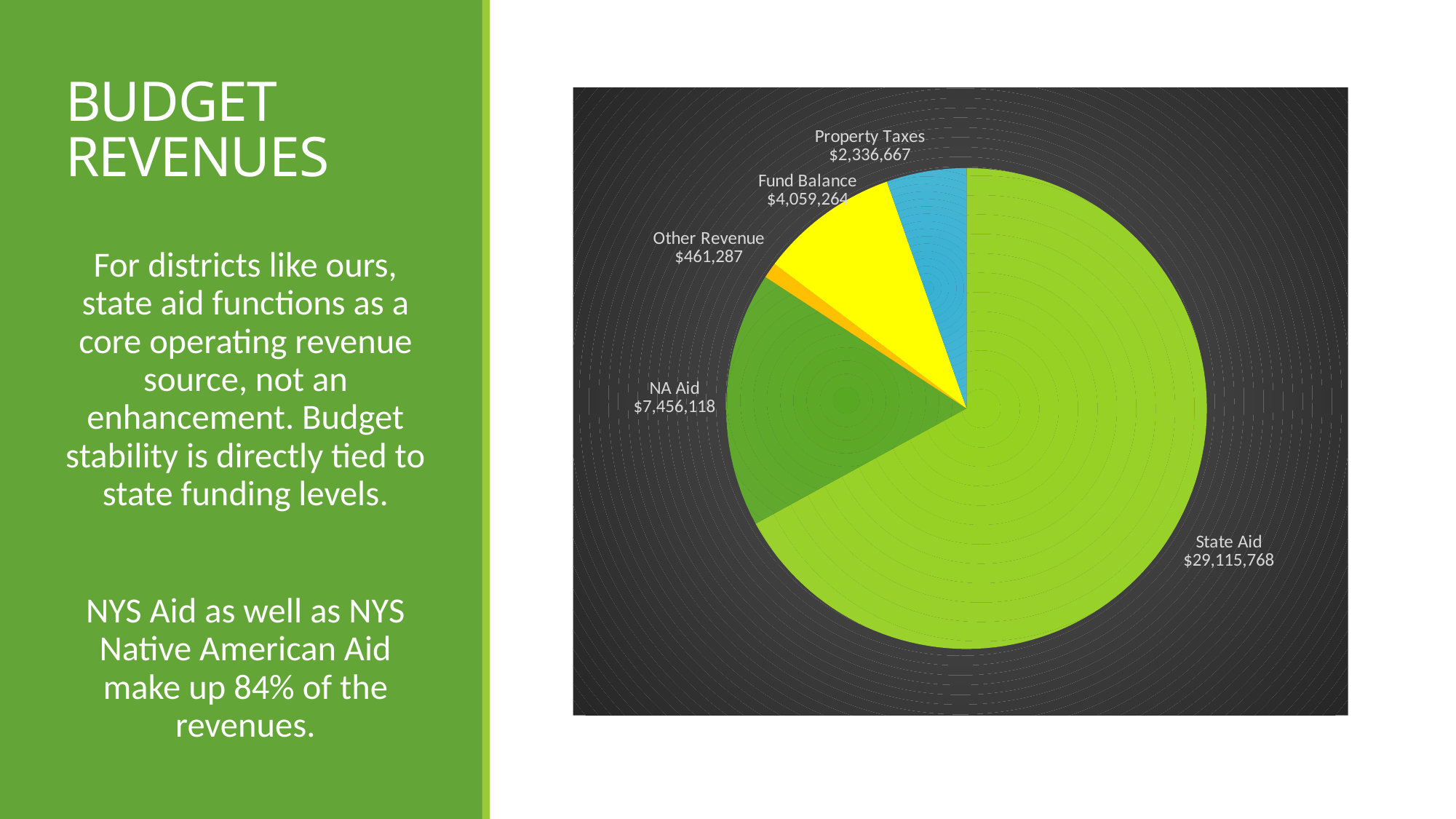
Which is larger in the pie chart, Fund Balance or Property Taxes? Fund Balance How much larger is State Aid than NA Aid in the pie chart? $21,659,650 What is the value shown for NA Aid in the pie chart? $7,456,118 What is the value shown for Property Taxes in the pie chart? $2,336,667 What type of chart is shown on the slide? Pie chart What is the value shown for Other Revenue in the pie chart? $461,287 Which revenue category has the largest slice in the pie chart? State Aid Which revenue category has the smallest slice in the pie chart? Other Revenue What is the value shown for Fund Balance in the pie chart? $4,059,264 What is the difference between Fund Balance and Property Taxes in the pie chart? $1,722,597 What is the value shown for State Aid in the pie chart? $29,115,768 How many revenue categories are shown in the pie chart? 5